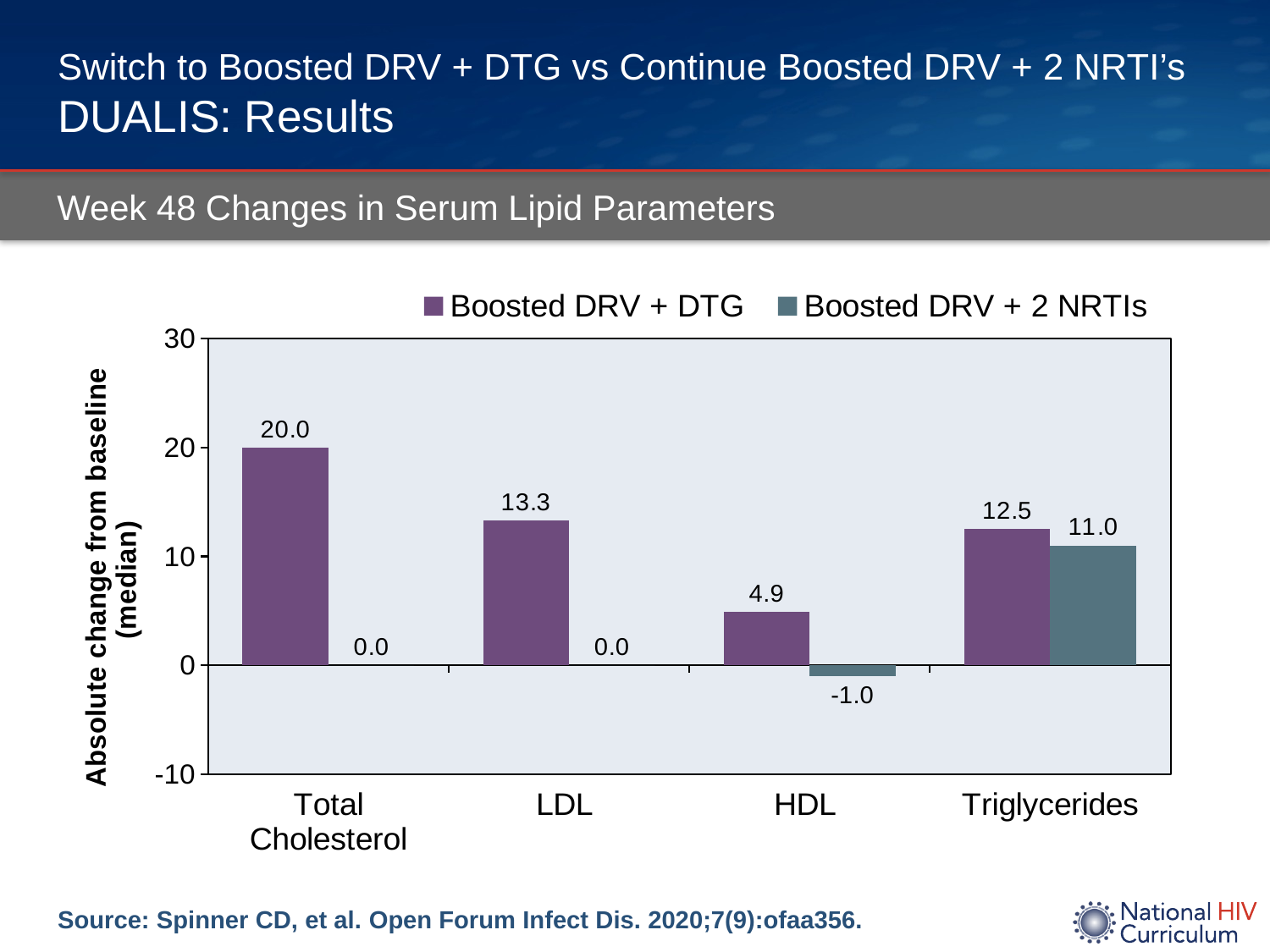
What is the difference between the Total Cholesterol and LDL values for the Boosted DRV + DTG group? 6.7 Which lipid parameter has the lowest value for the Boosted DRV + DTG group? HDL What is the absolute change from baseline in HDL for the Boosted DRV + 2 NRTIs group? -1.0 Which lipid parameter has the highest value for the Boosted DRV + DTG group? Total Cholesterol What is the absolute change from baseline in LDL for the Boosted DRV + DTG group? 13.3 What is the absolute change from baseline in Triglycerides for the Boosted DRV + 2 NRTIs group? 11.0 How many lipid parameter categories are shown on the x axis? 4 What is the difference between the Boosted DRV + DTG and Boosted DRV + 2 NRTIs values for Triglycerides? 1.5 For HDL, which group has the larger value, Boosted DRV + DTG or Boosted DRV + 2 NRTIs? Boosted DRV + DTG What kind of chart is shown on the slide? Bar chart How many series does the legend list? 2 What is the absolute change from baseline in Total Cholesterol for the Boosted DRV + DTG group? 20.0